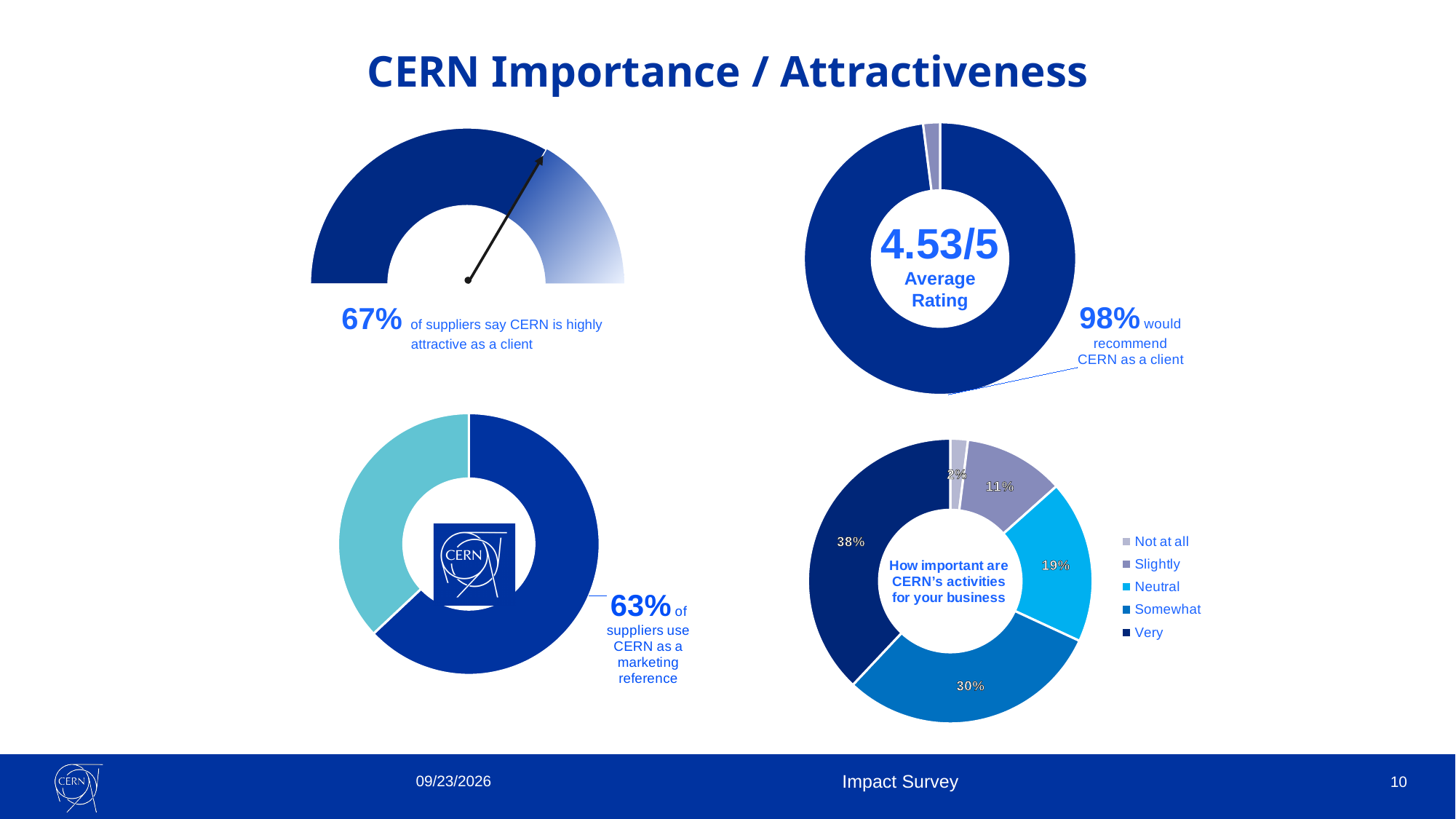
In the bottom-right chart 'How important are CERN's activities for your business', what is the difference between the 'Very' and 'Slightly' shares? 27% In the bottom-right chart 'How important are CERN's activities for your business', what share of respondents answered 'Not at all'? 2% In the bottom-right chart 'How important are CERN's activities for your business', what share of respondents answered 'Somewhat'? 30% In the bottom-right chart 'How important are CERN's activities for your business', what share of respondents answered 'Neutral'? 19% What kind of chart is the bottom-right chart 'How important are CERN's activities for your business'? Donut (pie) chart In the bottom-right chart 'How important are CERN's activities for your business', what share of respondents answered 'Very'? 38% In the bottom-right chart 'How important are CERN's activities for your business', which category has the smallest share? Not at all According to the top-right donut chart, what percentage of suppliers would recommend CERN as a client? 98% How many categories does the legend of the bottom-right chart 'How important are CERN's activities for your business' list? 5 In the bottom-right chart 'How important are CERN's activities for your business', which is larger: the 'Somewhat' share or the 'Neutral' share? Somewhat According to the bottom-left donut chart, what percentage of suppliers use CERN as a marketing reference? 63% In the bottom-right chart 'How important are CERN's activities for your business', which category has the largest share? Very